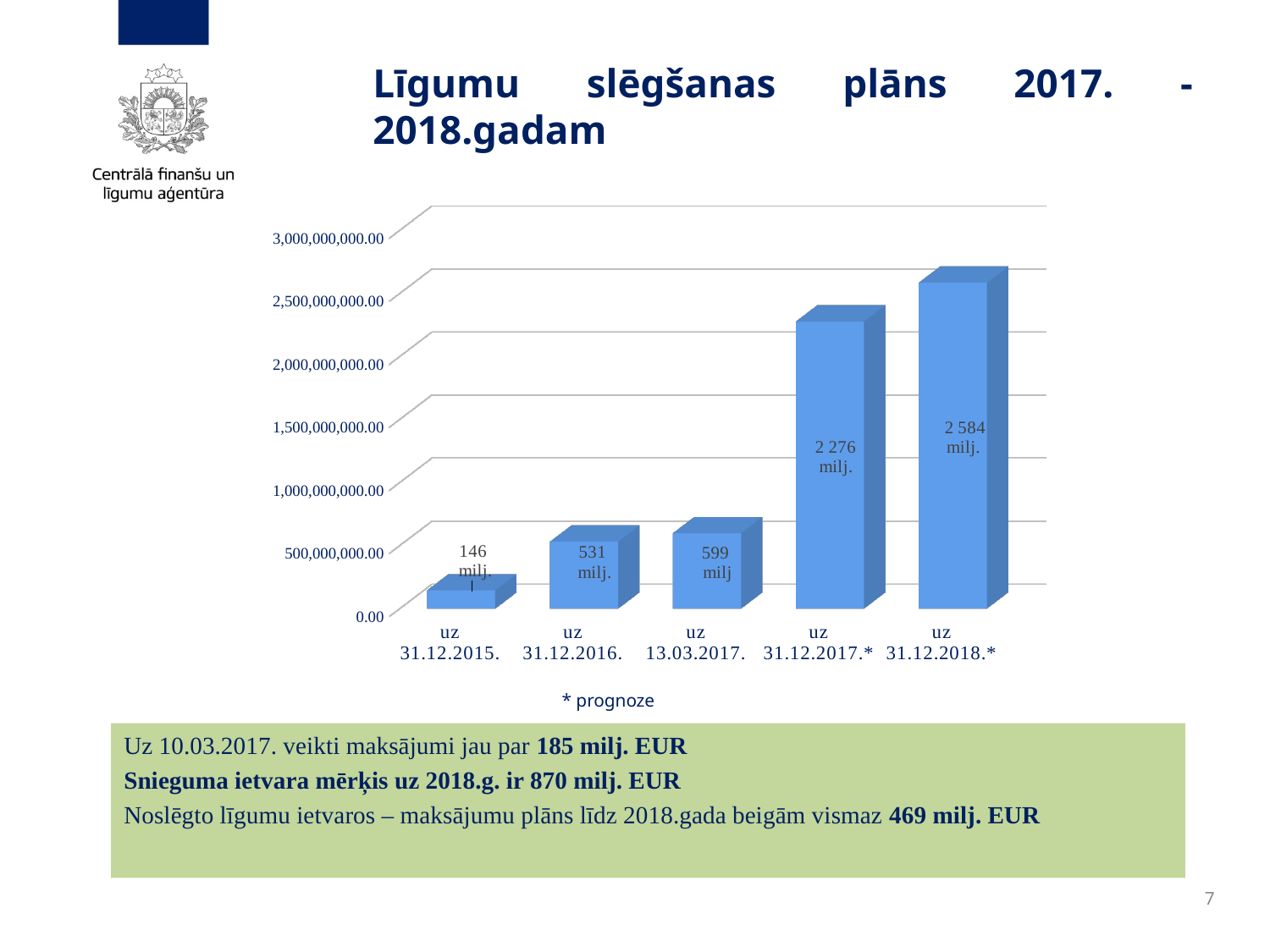
How many categories are shown on the x axis? 5 What kind of chart is shown on the slide? bar chart Which category has the lowest value? uz 31.12.2015. What value is shown for uz 31.12.2016.? 531 milj. What value is shown for uz 31.12.2015.? 146 milj. Which category has the highest value? uz 31.12.2018.* What is the difference between the values for uz 31.12.2018.* and uz 31.12.2017.*? 308 milj. What value is shown for uz 13.03.2017.? 599 milj Do the values rise or fall from left to right along the x axis? rise Which is larger, the value for uz 31.12.2016. or the value for uz 13.03.2017.? uz 13.03.2017. Is the value for uz 31.12.2017.* greater or less than 2,000,000,000.00? greater What value is shown for uz 31.12.2017.*? 2 276 milj.